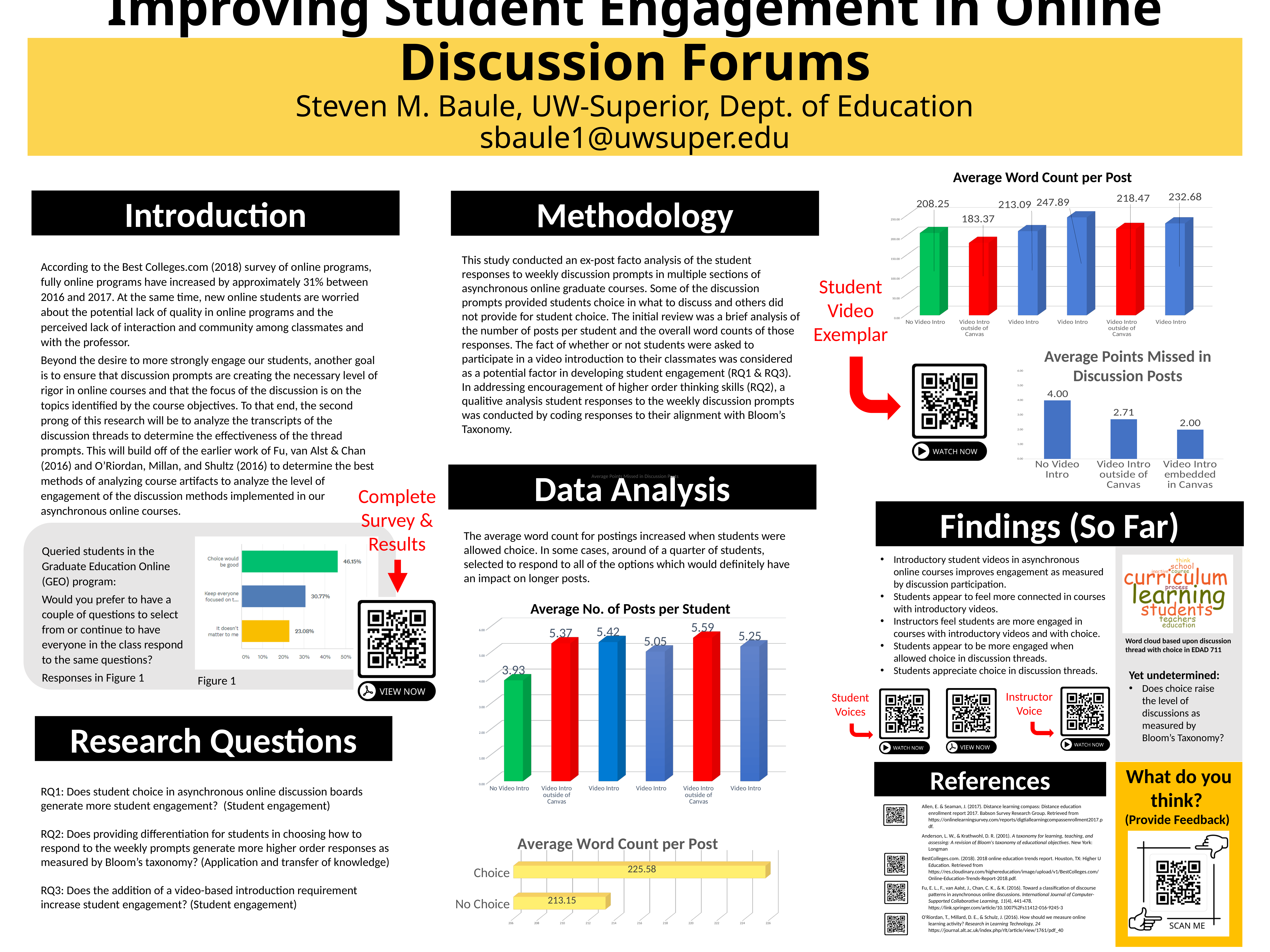
In the horizontal 'Average Word Count per Post' chart at the bottom of the Data Analysis section, what is the value for No Choice? 213.15 In the 'Average Points Missed in Discussion Posts' chart, how many categories are shown? 3 In Figure 1, what percentage of respondents said 'Choice would be good'? 46.15% In the 'Average Points Missed in Discussion Posts' chart, what is the difference between No Video Intro and Video Intro outside of Canvas? 1.29 In the horizontal 'Average Word Count per Post' chart at the bottom of the Data Analysis section, which is larger, Choice or No Choice? Choice In the horizontal 'Average Word Count per Post' chart at the bottom of the Data Analysis section, what is the value for Choice? 225.58 In the 'Average No. of Posts per Student' chart, what is the highest value shown? 5.59 In the 'Average Word Count per Post' chart at the top right of the slide, what is the highest value shown? 247.89 In the 'Average Word Count per Post' chart at the top right of the slide, what is the lowest value shown? 183.37 In the 'Average Points Missed in Discussion Posts' chart, what is the value for No Video Intro? 4.00 In the 'Average Points Missed in Discussion Posts' chart, which category has the lowest value? Video Intro embedded in Canvas In the 'Average No. of Posts per Student' chart, what is the value for the first bar, No Video Intro? 3.93